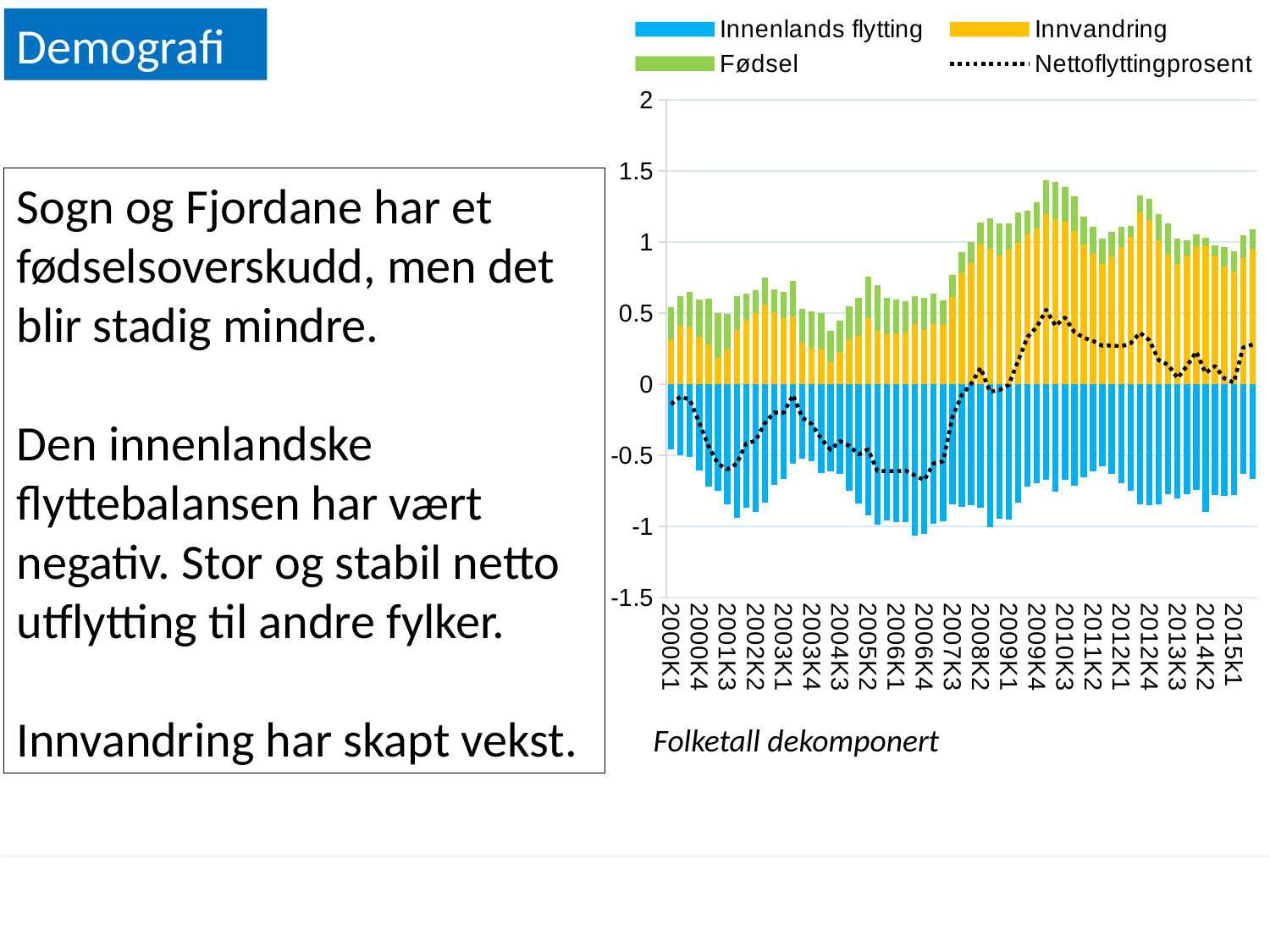
Which series has negative values throughout the whole period? Innenlands flytting How many series does the legend list? 4 What is the highest value shown on the y axis? 2 Does the Nettoflyttingprosent line rise or fall between 2006K4 and 2010K3? rise Is the value for Nettoflyttingprosent at 2010K3 greater or less than 0? greater Is the value for Innvandring at 2000K1 greater or less than 0.5? less Is the value for Innenlands flytting at 2001K3 greater or less than -0.5? less What is the caption/title shown below the chart? Folketall dekomponert What kind of chart is this? Stacked bar chart with a line Which series is drawn as a dotted line? Nettoflyttingprosent